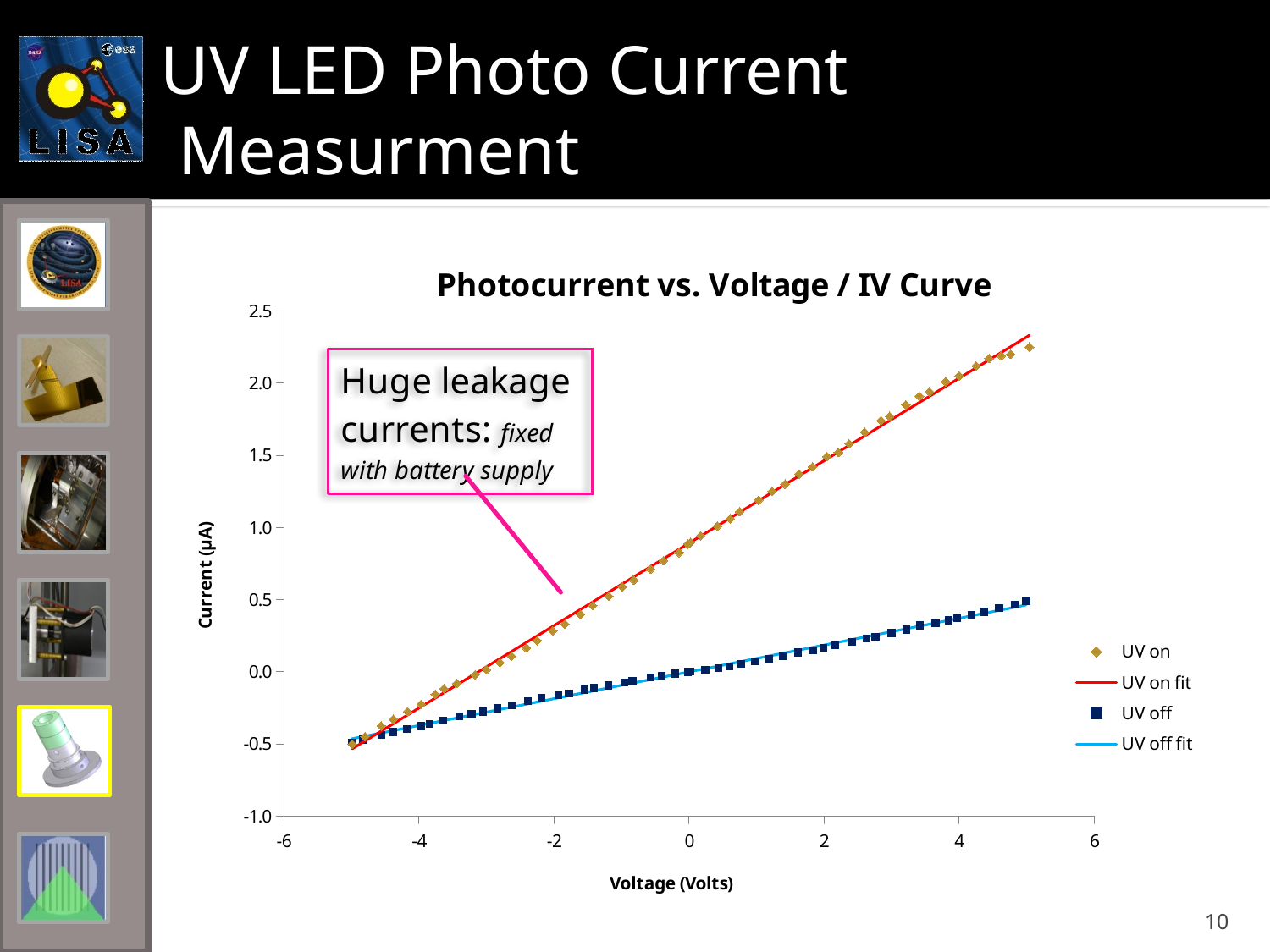
Does the UV on current rise or fall as voltage increases along the x axis? Rise At 4 Volts, which series has the larger current, UV on or UV off? UV on Is the UV off current at 2 Volts greater or less than 0.5 µA? less Does the UV off current rise or fall as voltage increases along the x axis? Rise How many series does the chart legend list? 4 Is the UV on current at 5 Volts greater or less than 2.0 µA? greater What kind of chart is shown on the slide? Scatter chart with fit lines What is the label of the x axis? Voltage (Volts) Is the UV on current at -5 Volts greater or less than 0.0 µA? less What is the title of the chart? Photocurrent vs. Voltage / IV Curve